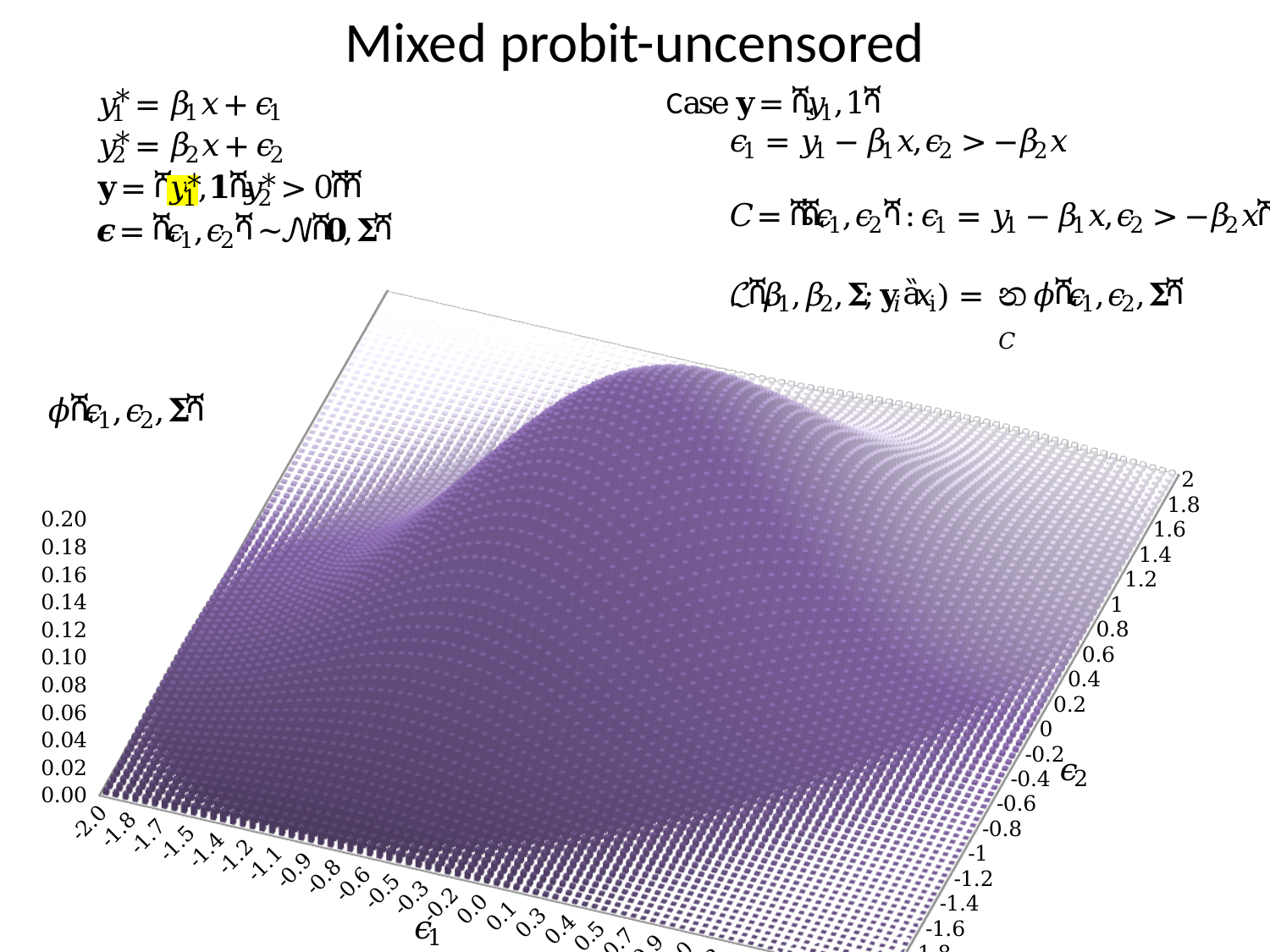
What kind of chart is shown on the slide? 3D surface chart What is the lowest tick value shown on the vertical axis of the surface chart? 0.00 What is the interval between consecutive tick marks on the vertical axis of the surface chart? 0.02 What is the highest tick value shown on the vertical axis of the surface chart? 0.20 What is the label of the horizontal axis running along the front-left edge of the surface chart? ε1 Does the surface rise monotonically, fall monotonically, or rise and then fall as ε2 increases from -1.8 to 2? rise and then fall How many tick labels are printed on the vertical axis of the surface chart? 11